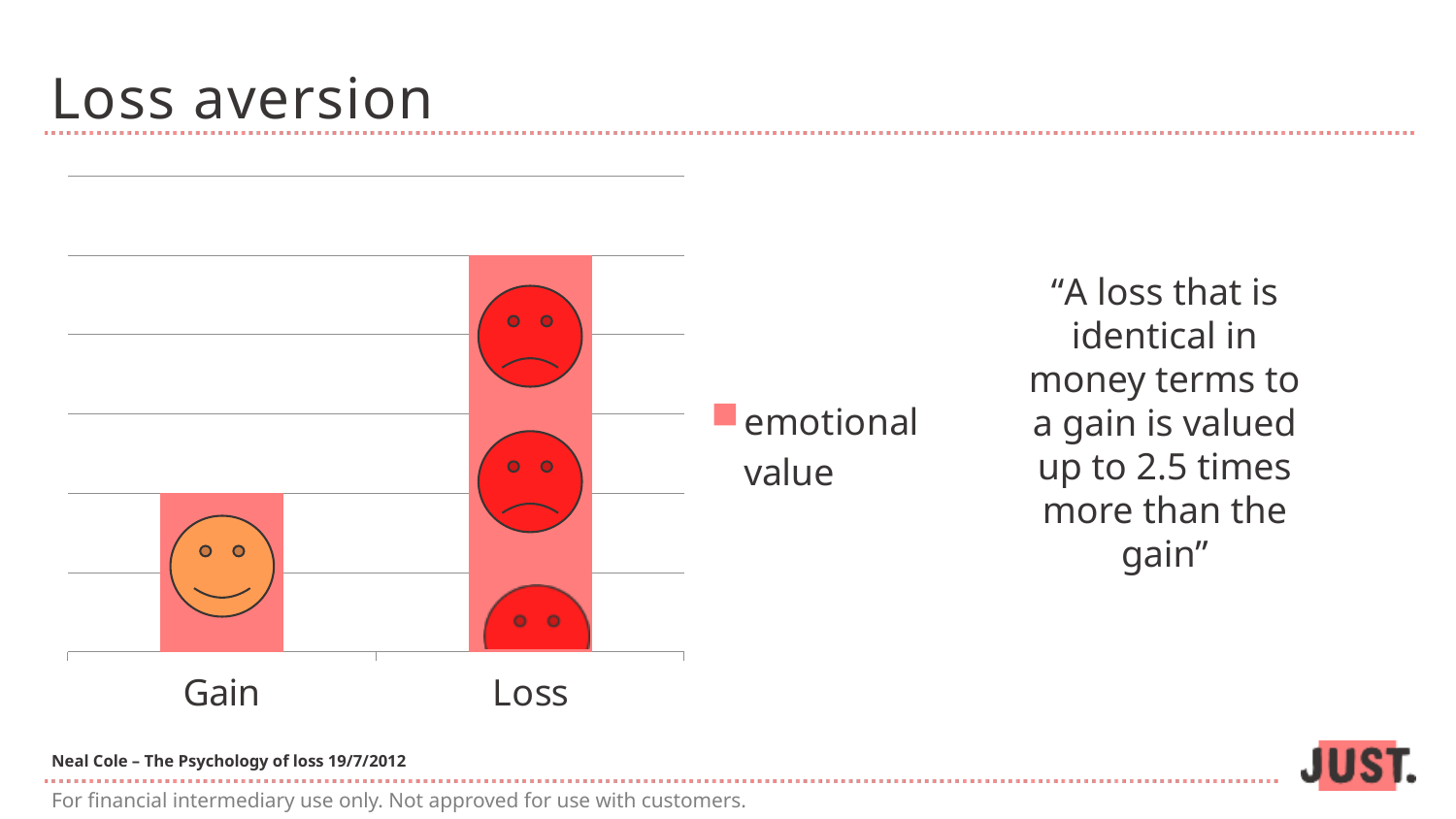
What is the name of the series shown in the chart's legend? emotional value Which bar is taller, Gain or Loss? Loss Which category has the lowest bar in the chart? Gain How many categories are plotted on the x axis of the chart? 2 How many series does the chart's legend list? 1 What kind of chart is shown on the slide? bar chart Do the bar values rise or fall moving from Gain to Loss along the x axis? rise What are the two category labels on the x axis of the chart? Gain and Loss Which category has the highest bar in the chart? Loss